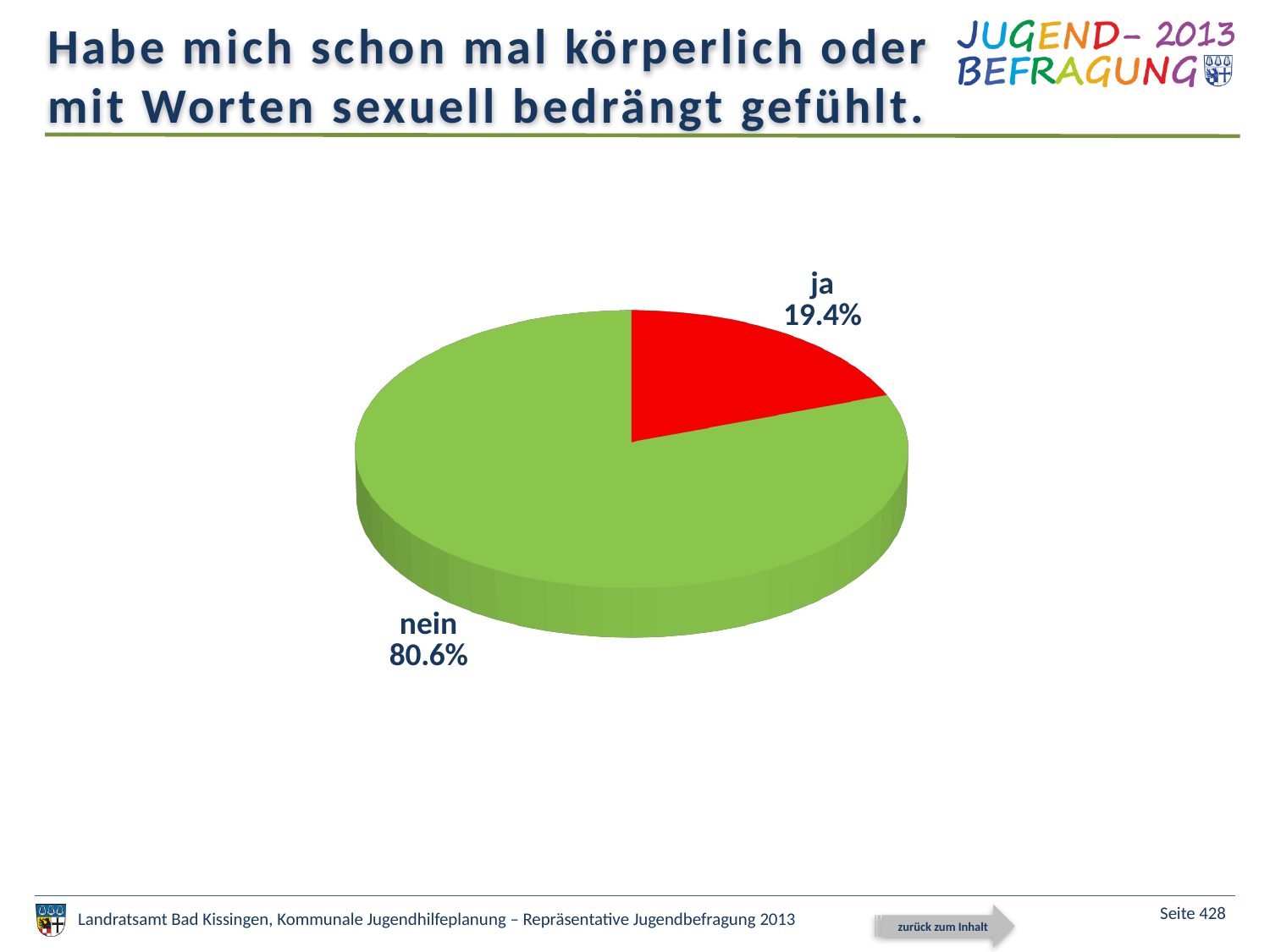
What is the difference in percentage points between the "nein" and "ja" shares? 61.2 Which category has the largest share of the pie? nein What colour is the "nein" slice? green Which is larger, the share for "ja" or the share for "nein"? nein What colour is the "ja" slice? red What percentage of respondents answered "ja"? 19.4% What kind of chart is shown on the slide? pie chart Which category has the smallest share of the pie? ja What share of the pie does the "ja" slice represent? 19.4% What percentage of respondents answered "nein"? 80.6% How many categories are shown in the pie chart? 2